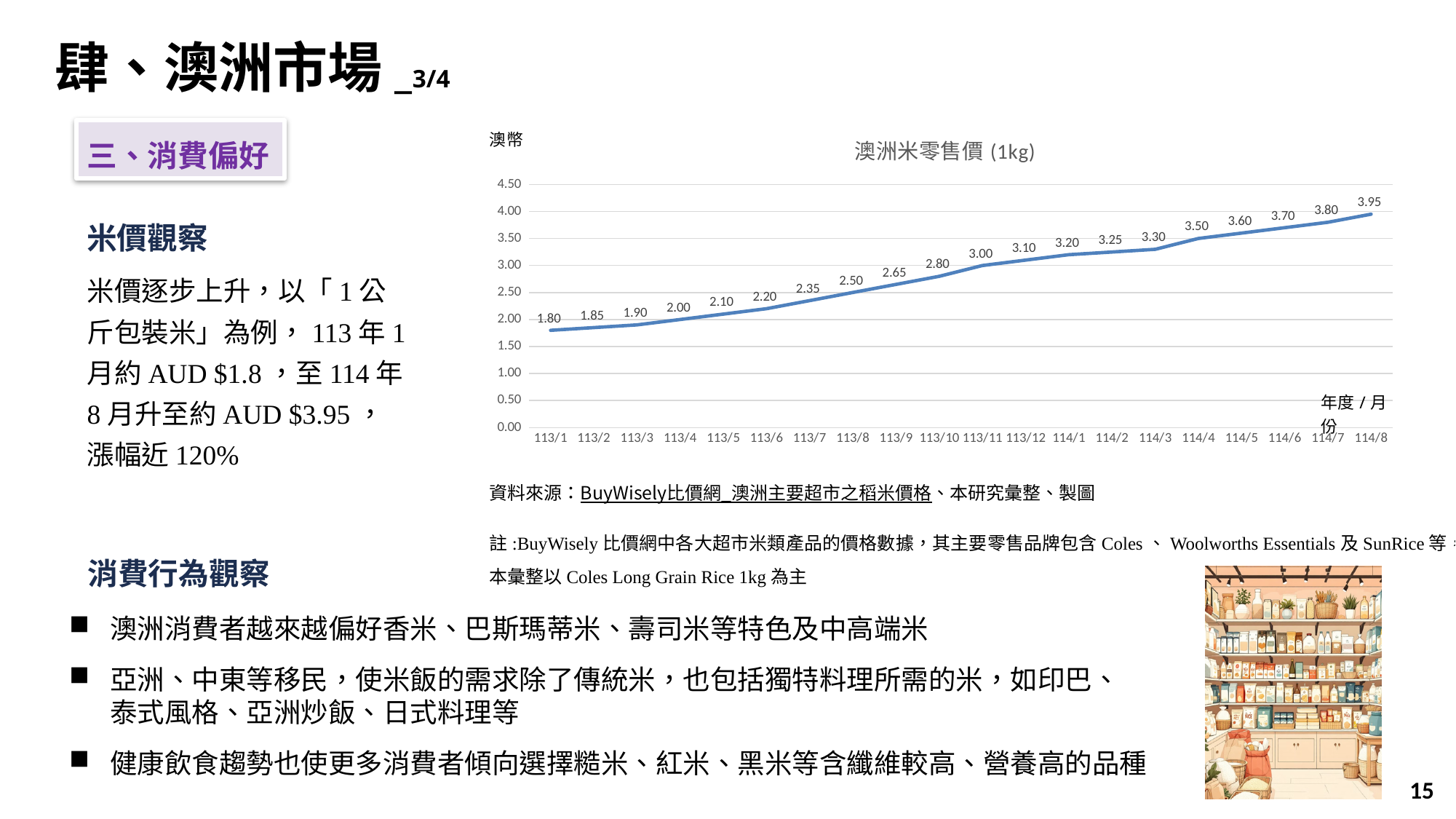
Which is larger, the value for 113/8 or the value for 114/1? 114/1 How many data points are plotted on the chart? 20 What type of chart is shown on the slide? line chart What is the value for 114/8? 3.95 Do the values rise or fall from 113/1 to 114/8? rise Which month has the highest value? 114/8 What is the value for 114/3? 3.30 Which month has the lowest value? 113/1 What is the title of the chart? 澳洲米零售價 (1kg) What is the difference between the values for 114/8 and 113/1? 2.15 What is the value for 113/11? 3.00 What is the value for 113/1? 1.80